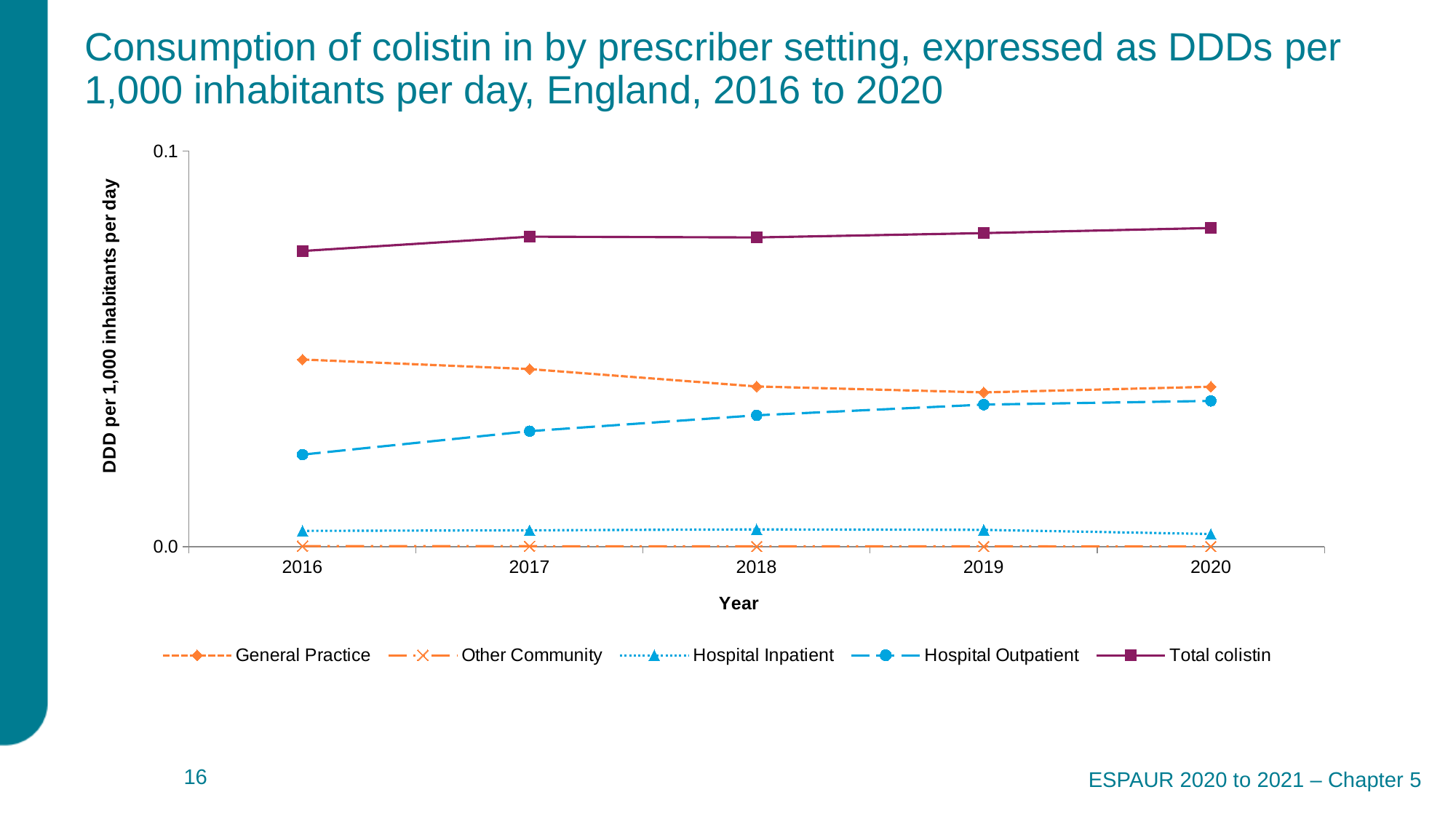
Does the General Practice series rise or fall from 2016 to 2019? fall Which series has the highest values across all years? Total colistin In 2016, which is larger: General Practice or Hospital Outpatient? General Practice Does the Hospital Outpatient series rise or fall from 2016 to 2020? rise How many years are plotted along the x axis? 5 Which series has the lowest values across all years? Other Community In which year is the General Practice value highest? 2016 What kind of chart is shown on the slide? line chart What is the label on the y axis? DDD per 1,000 inhabitants per day How many series does the legend list? 5 Is the Total colistin value for 2020 greater or less than 0.1? less In which year is the Hospital Outpatient value lowest? 2016